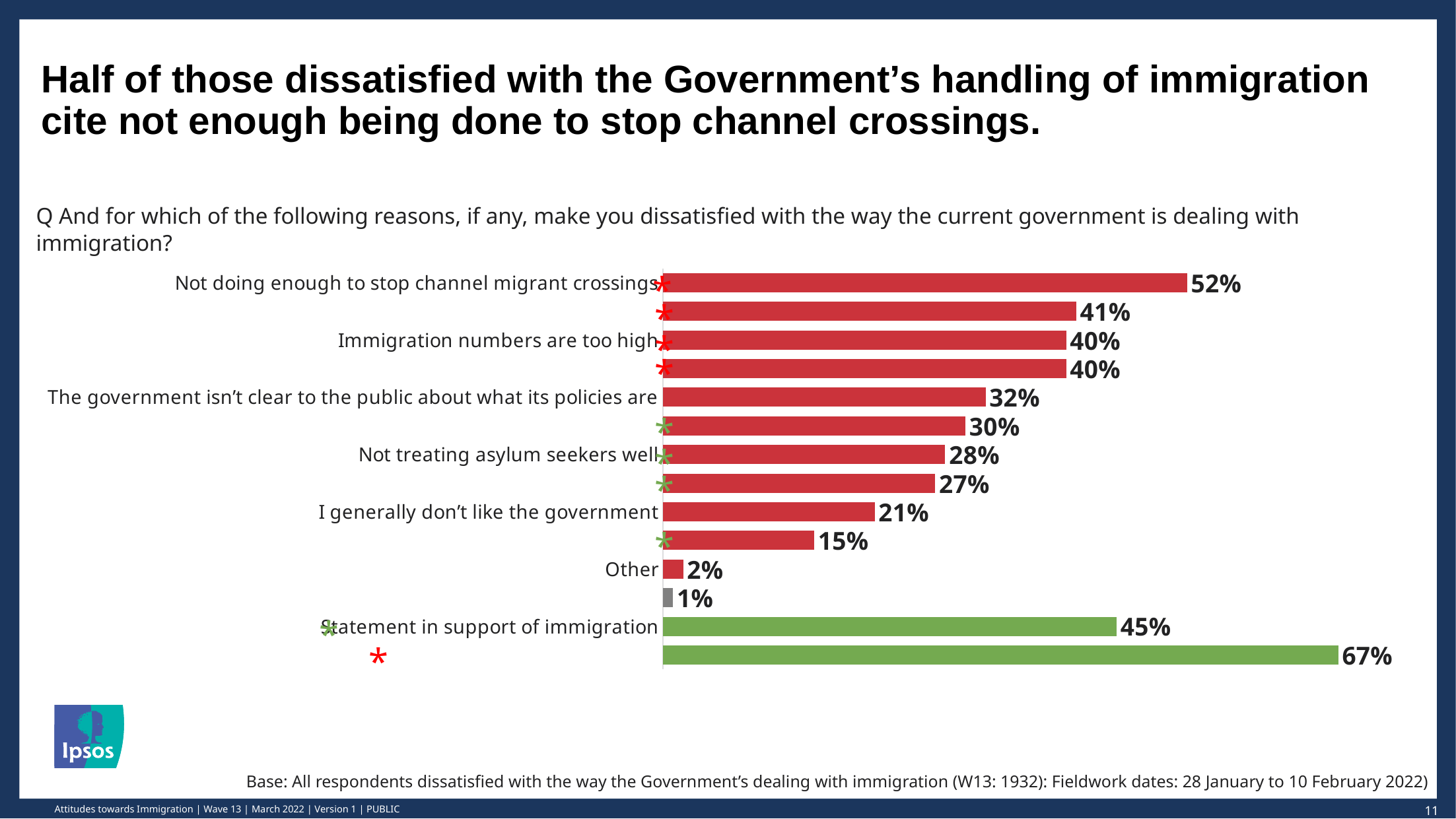
What is the difference between the values for 'Not doing enough to stop channel migrant crossings' and 'Immigration numbers are too high'? 12 percentage points Which is larger: the value for 'Not treating asylum seekers well' or for 'I generally don't like the government'? Not treating asylum seekers well What is the value shown for 'Immigration numbers are too high'? 40% What type of chart is shown on the slide? Bar chart How many bars are plotted on the chart? 14 What percentage is shown for 'I generally don't like the government'? 21% What is the value for 'Not treating asylum seekers well'? 28% What percentage of respondents cite 'Not doing enough to stop channel migrant crossings'? 52% What percentage is shown for 'The government isn't clear to the public about what its policies are'? 32% What is the lowest value shown on the chart? 1% What is the value for 'Statement in support of immigration'? 45% What is the highest value shown on the chart? 67%